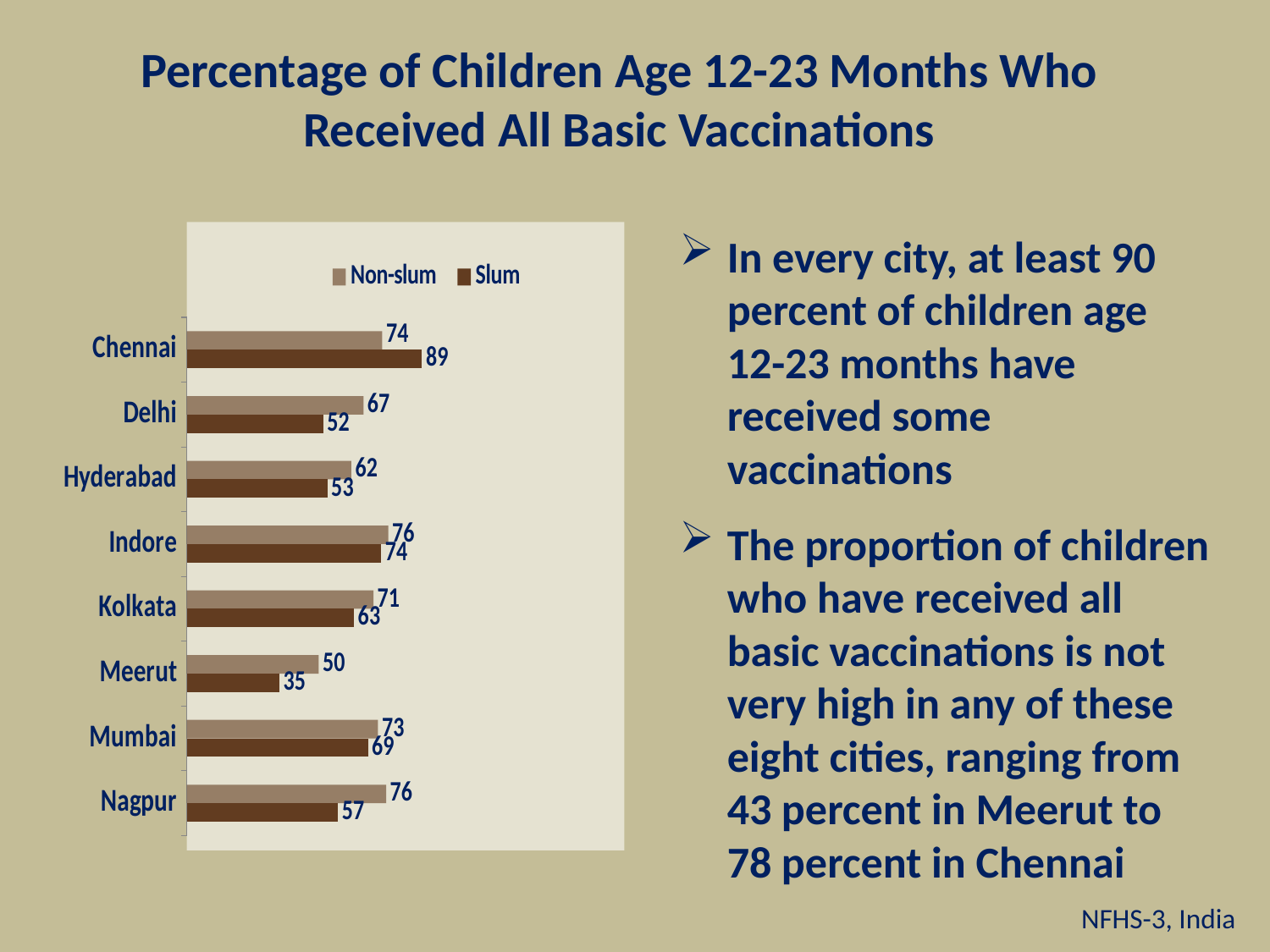
Which is larger, the Slum value for Chennai or the Slum value for Mumbai? Chennai What kind of chart is shown on the slide? Bar chart How many series does the legend list? 2 Which series is shown in the darker brown colour? Slum What is the Non-slum value for Chennai? 74 What is the Slum value for Meerut? 35 Which is larger for Delhi, the Non-slum value or the Slum value? Non-slum What is the Slum value for Nagpur? 57 Which city has the highest Slum value? Chennai What is the difference between the Non-slum and Slum values for Nagpur? 19 How many cities are shown in the chart? 8 Which city has the lowest Non-slum value? Meerut